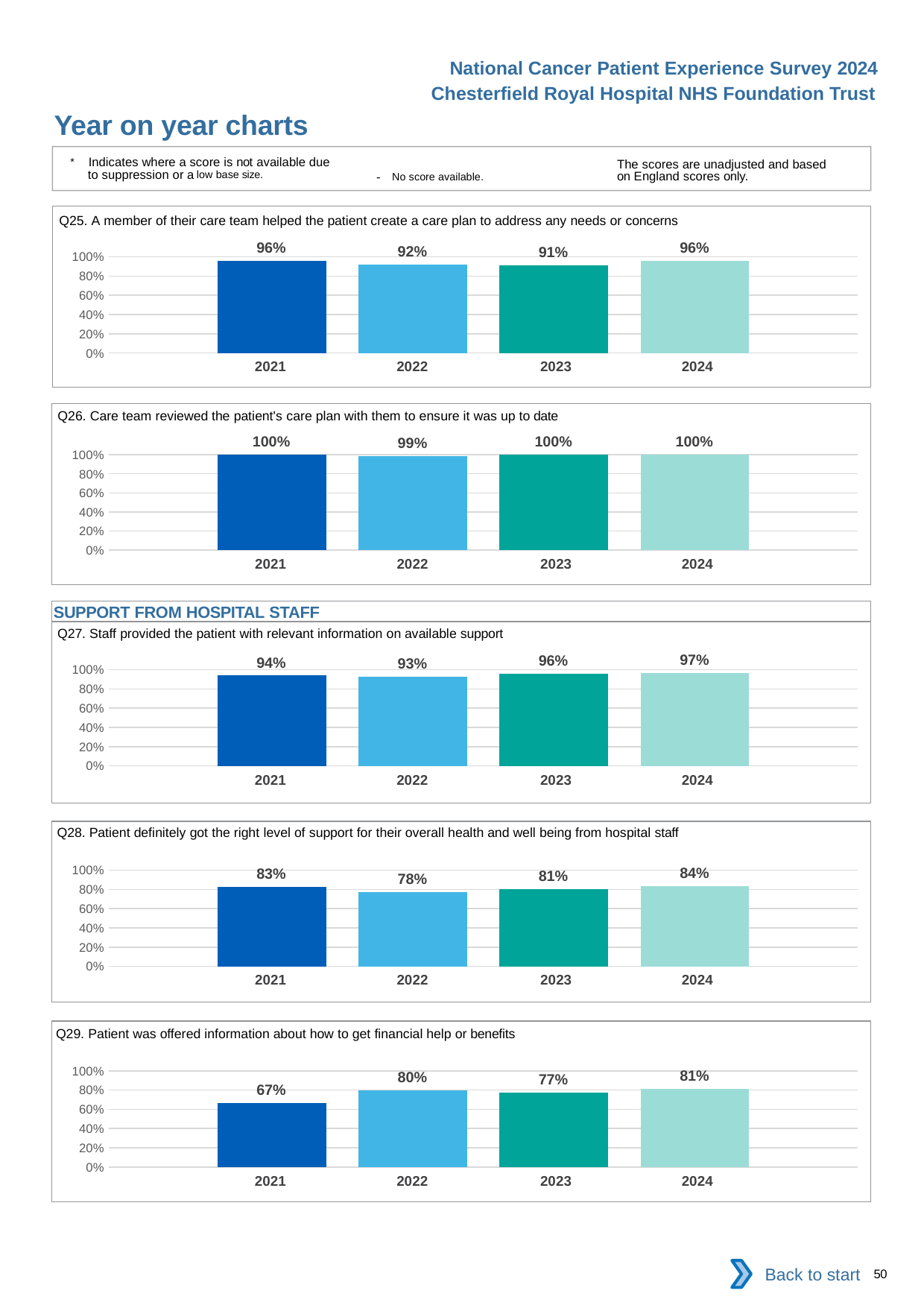
In the Q26 chart, what is the value for 2022? 99% In the Q29 chart, which is larger, the value for 2022 or the value for 2023? 2022 In the Q28 chart, what is the value for 2021? 83% In the Q27 chart, which year has the highest value? 2024 In the Q29 chart, what is the value for 2021? 67% In the Q25 chart, what is the value for 2022? 92% In the Q26 chart, how many years are plotted? 4 In the Q28 chart, which year has the lowest value? 2022 In the Q25 chart, which year has the lowest value? 2023 In the Q29 chart, what is the difference between the 2024 and 2021 values? 14 percentage points In the Q27 chart, what is the difference between the 2024 and 2022 values? 4 percentage points What kind of chart is the Q28 chart? Bar chart